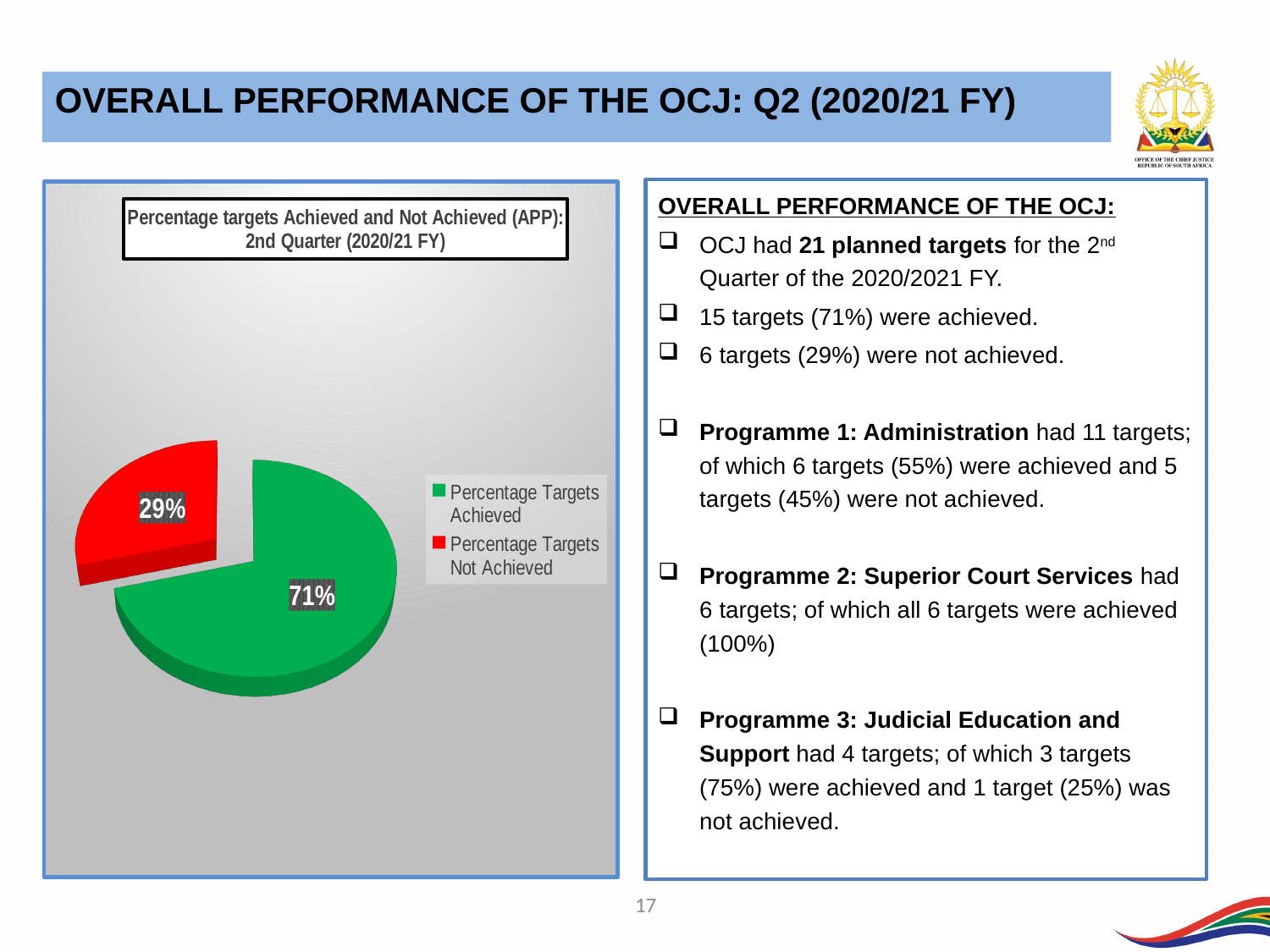
How many entries does the chart legend list? 2 What share of the pie does the green slice represent? 71% Which slice of the pie chart is the largest? Percentage Targets Achieved What is the title of the chart? Percentage targets Achieved and Not Achieved (APP): 2nd Quarter (2020/21 FY) Is the share of targets achieved larger or smaller than the share of targets not achieved? Larger What kind of chart is shown on the slide? Pie chart What percentage of targets were achieved according to the pie chart? 71% How many slices does the pie chart have? 2 Which slice of the pie chart is the smallest? Percentage Targets Not Achieved What is the difference in percentage points between targets achieved and targets not achieved? 42 What percentage of targets were not achieved according to the pie chart? 29% What colour represents Percentage Targets Not Achieved in the pie chart? Red